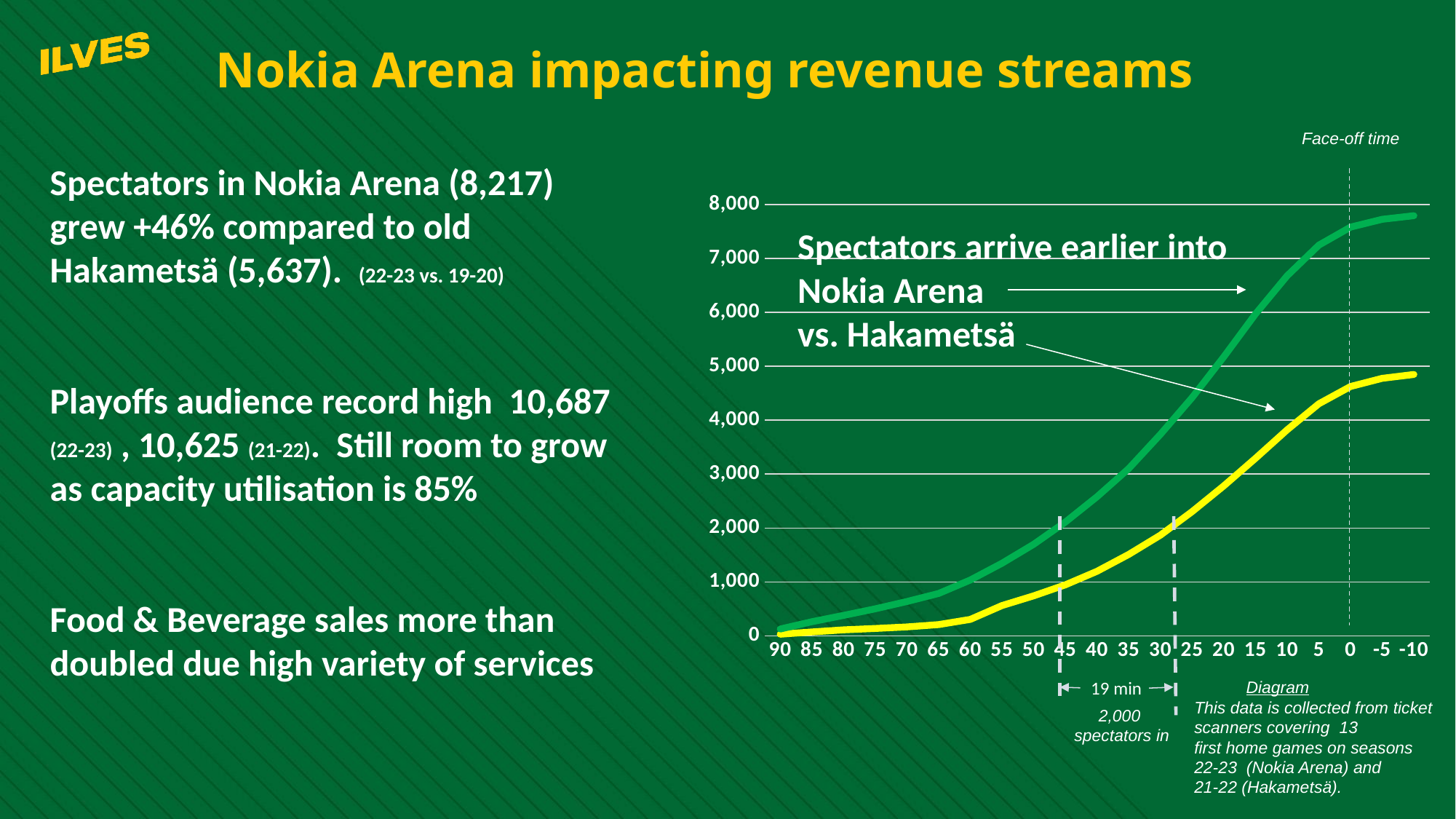
How many tick labels are shown on the x axis of the chart? 21 What kind of chart is shown on the slide? line chart What colour is the Nokia Arena line on the chart? green Is the Hakametsä value at 15 minutes before face-off greater or less than 3,000? greater Is the Hakametsä value at face-off time (0) greater or less than 4,000? greater How many series are plotted on the chart? 2 At 30 minutes before face-off, which series has more spectators, Nokia Arena or Hakametsä? Nokia Arena Is the Nokia Arena value at face-off time (0) greater or less than 7,000? greater Which two series are plotted on the chart? Nokia Arena and Hakametsä How many minutes earlier does Nokia Arena reach 2,000 spectators compared to Hakametsä, according to the annotation? 19 min Do the spectator counts rise or fall as the x axis moves from 90 minutes toward face-off time? rise